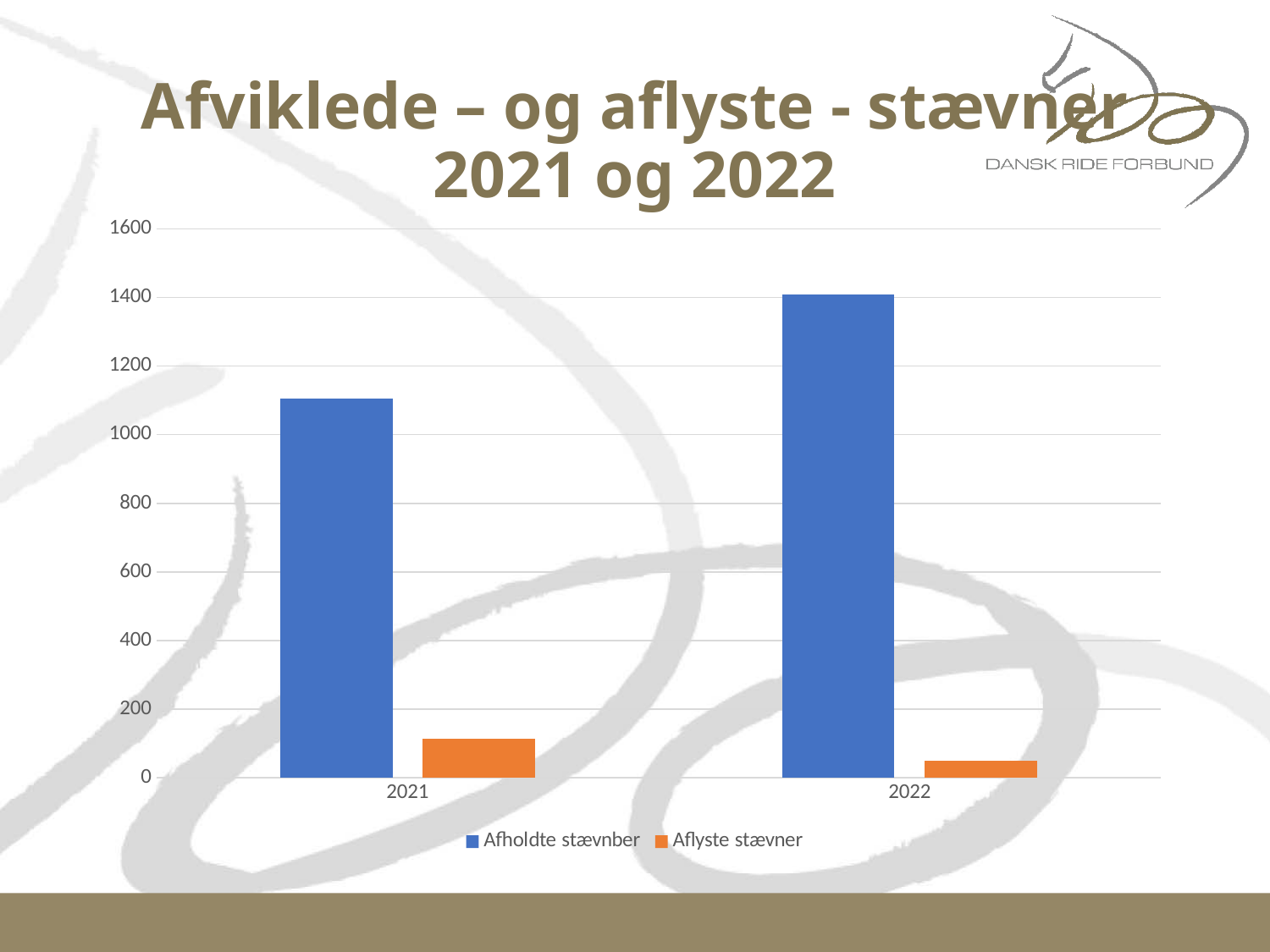
How many series does the legend list? 2 Which year has the lower value for Aflyste stævner? 2022 How many categories are shown on the x axis? 2 Is the value for Afholdte stævnber in 2022 greater or less than 1200? greater Is the value for Aflyste stævner in 2021 greater or less than 200? less Is the value for Afholdte stævnber in 2021 greater or less than 1000? greater Does the value for Aflyste stævner rise or fall from 2021 to 2022? Fall What kind of chart is shown on the slide? Bar chart What colour are the bars for Aflyste stævner? Orange Does the value for Afholdte stævnber rise or fall from 2021 to 2022? Rise Which year has the higher value for Afholdte stævnber? 2022